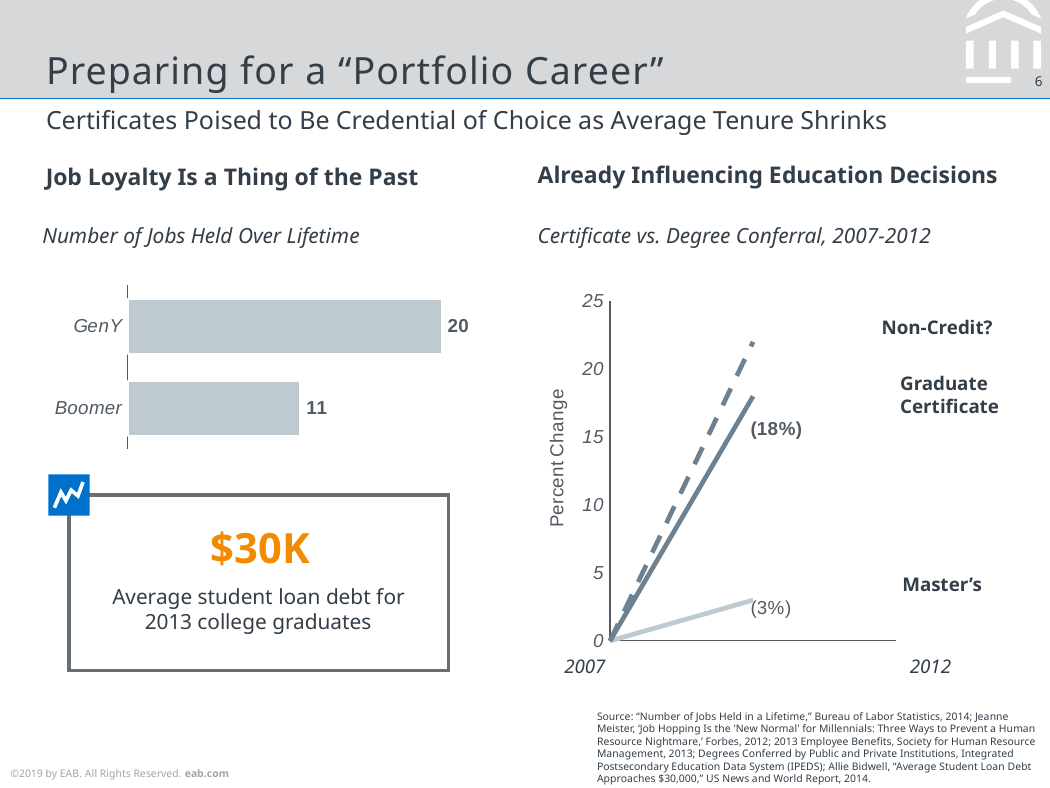
In the "Number of Jobs Held Over Lifetime" chart, what is the value for GenY? 20 In the "Certificate vs. Degree Conferral, 2007-2012" chart, what percent change is labeled for Graduate Certificate? (18%) What kind of chart is "Number of Jobs Held Over Lifetime"? Bar chart In the "Number of Jobs Held Over Lifetime" chart, what is the value for Boomer? 11 In the "Number of Jobs Held Over Lifetime" chart, what is the difference between the GenY and Boomer values? 9 In the "Certificate vs. Degree Conferral, 2007-2012" chart, which line ends lowest in 2012? Master's In the "Certificate vs. Degree Conferral, 2007-2012" chart, what percent change is labeled for Master's? (3%) In the "Number of Jobs Held Over Lifetime" chart, how many categories are shown? 2 In the "Certificate vs. Degree Conferral, 2007-2012" chart, what is the label on the vertical axis? Percent Change In the "Certificate vs. Degree Conferral, 2007-2012" chart, is the 2012 value for Non-Credit? greater or less than 20? greater What kind of chart is "Certificate vs. Degree Conferral, 2007-2012"? Line chart In the "Number of Jobs Held Over Lifetime" chart, which category has the higher value? GenY